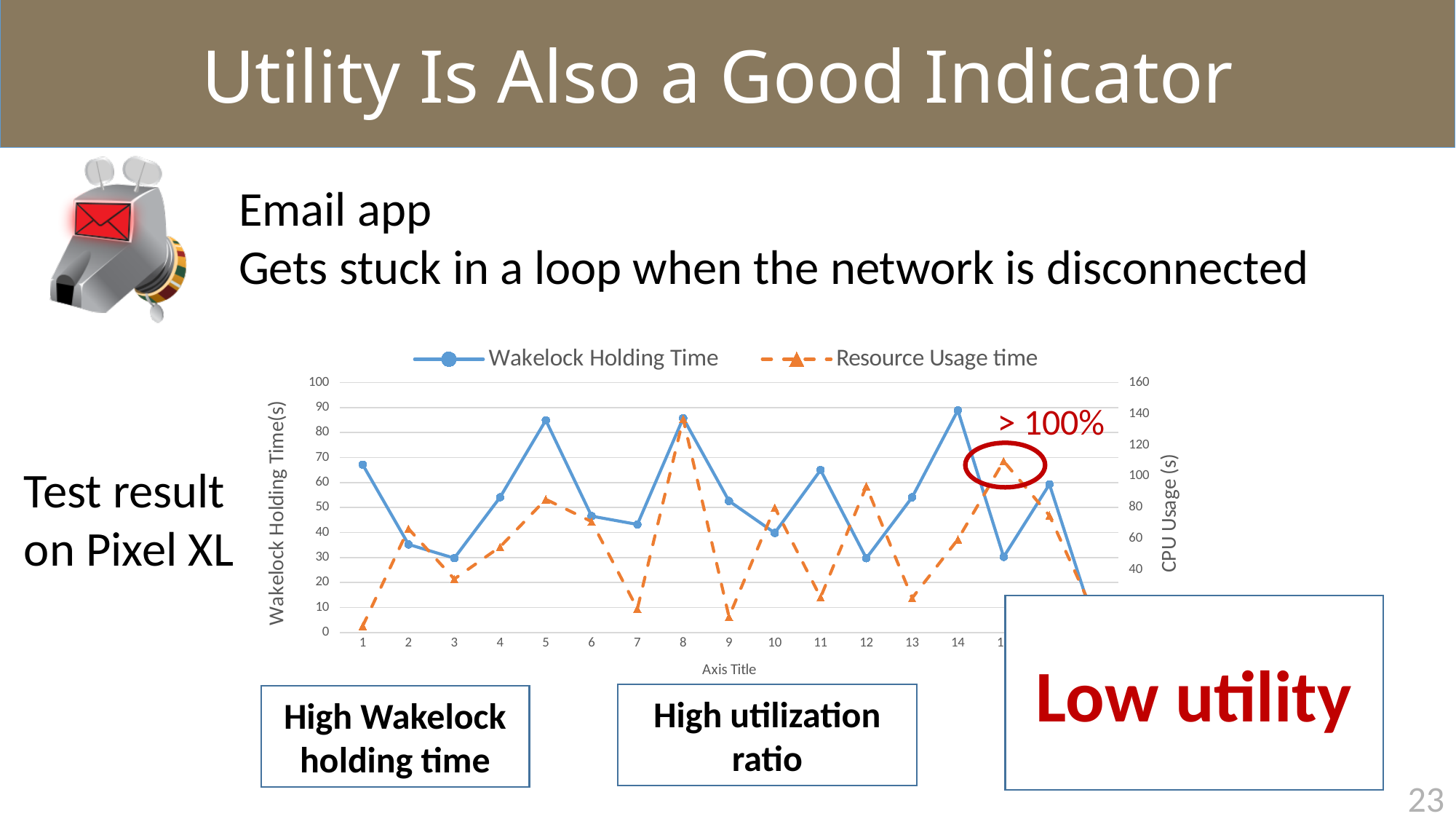
Is the Wakelock Holding Time value at x = 10 greater or less than 50? less Is the Wakelock Holding Time value at x = 14 greater or less than 80? greater Is the Wakelock Holding Time value at x = 3 greater or less than 40? less Which is larger, the Wakelock Holding Time at x = 1 or at x = 2? x = 1 What is the title of the left vertical axis of the chart? Wakelock Holding Time(s) Which is larger, the Wakelock Holding Time at x = 5 or at x = 6? x = 5 How many series does the chart's legend list? 2 What are the two series named in the chart's legend? Wakelock Holding Time and Resource Usage time What kind of chart is shown on the slide? line chart Which is larger, the Wakelock Holding Time at x = 11 or at x = 12? x = 11